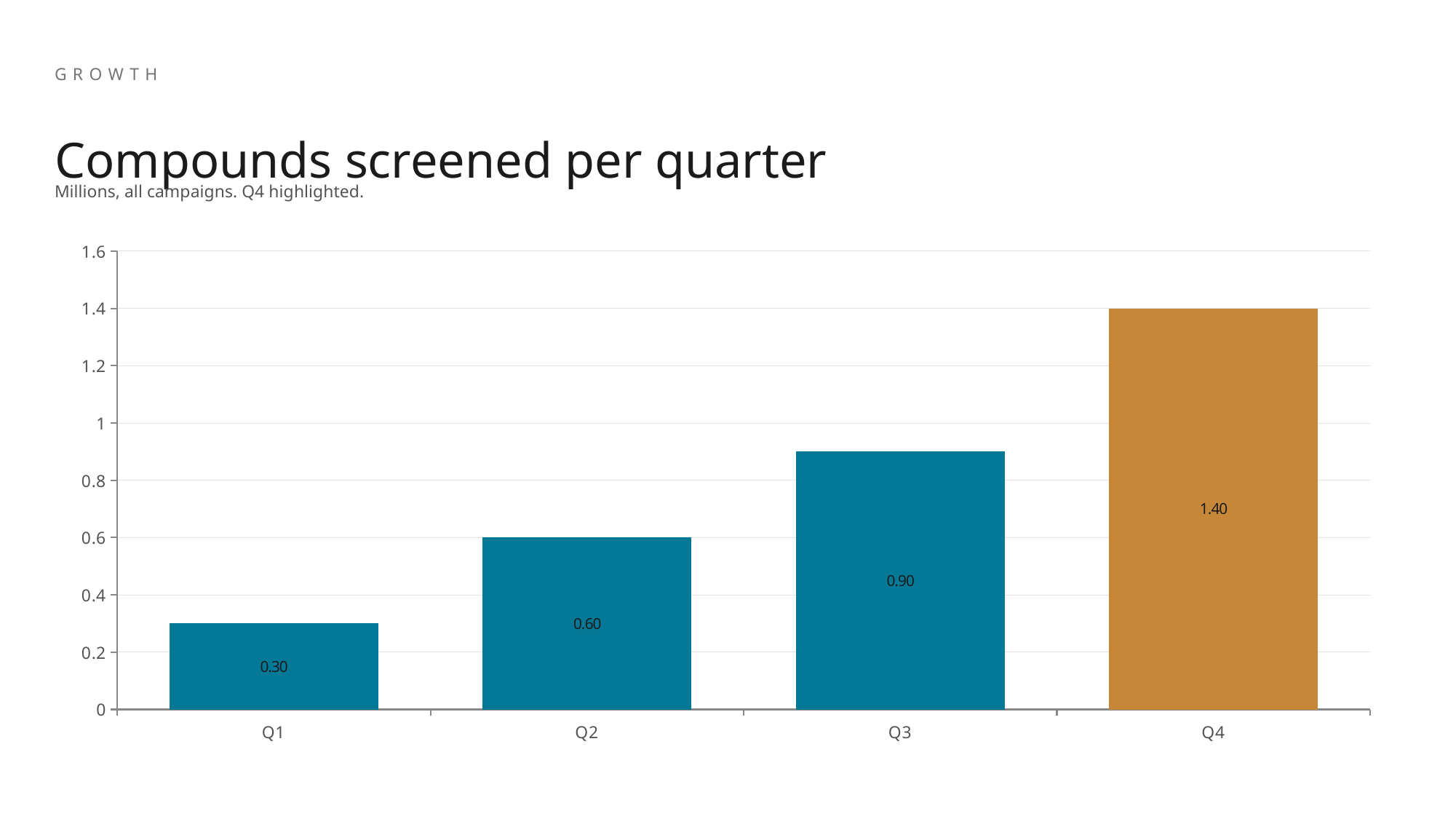
What kind of chart is shown on the slide? bar chart What is the difference between the values for Q2 and Q1? 0.30 What is the difference between the values for Q4 and Q3? 0.50 What is the value for Q1? 0.30 How many quarters are shown on the x axis? 4 Is the value for Q4 greater or less than 1.2? greater Do the values rise or fall from Q1 to Q4? rise Which is larger, the value for Q2 or the value for Q3? Q3 Which quarter has the lowest value? Q1 Which quarter has the highest value? Q4 What is the value for Q3? 0.90 What is the value for Q4? 1.40